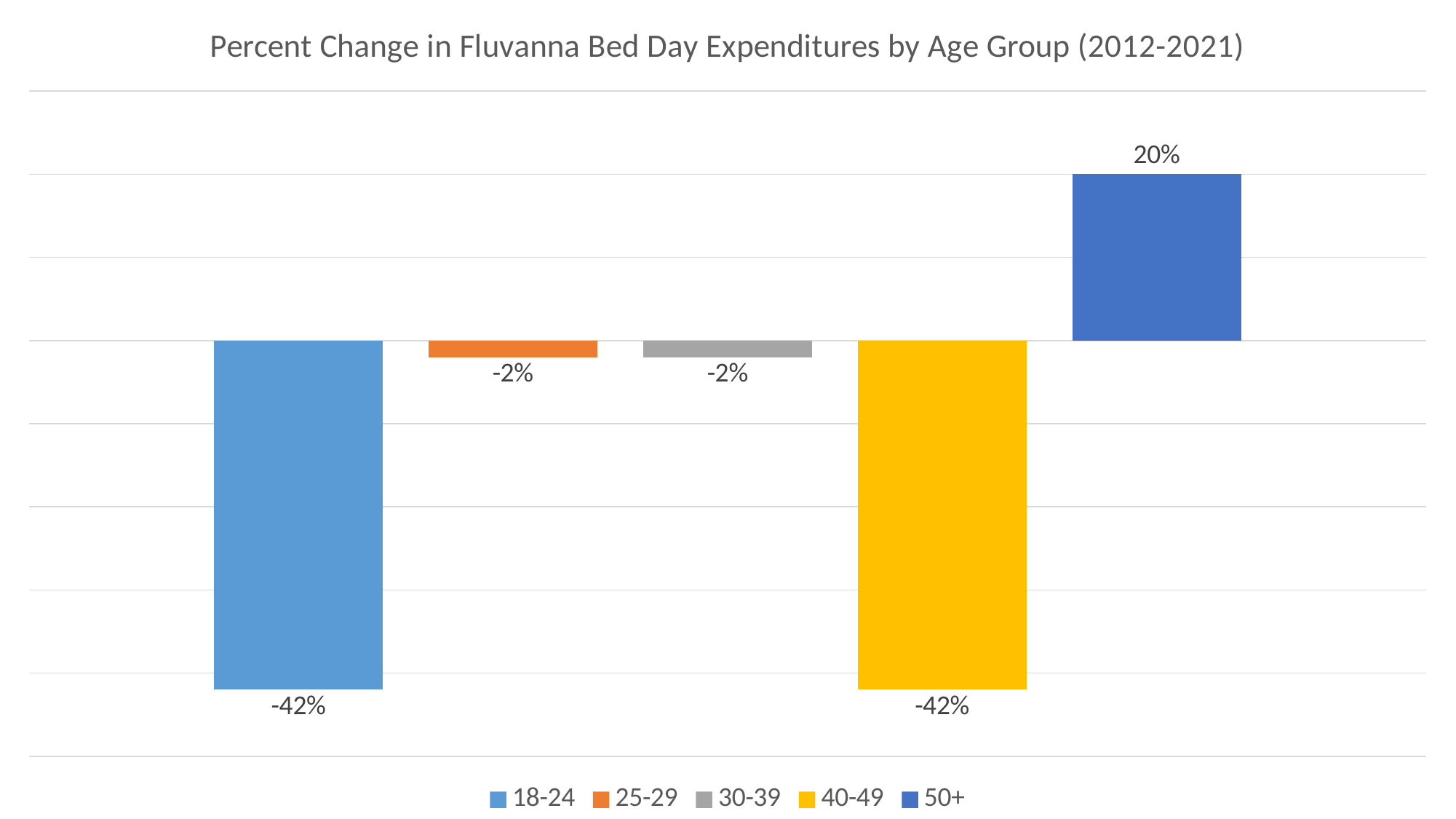
What is the percent change in Fluvanna bed day expenditures for the 40-49 age group? -42% What is the percent change in Fluvanna bed day expenditures for the 25-29 age group? -2% What is the difference between the percent change for the 50+ group and the 40-49 group? 62 percentage points How many age groups are shown in the chart? 5 How many entries does the legend list? 5 What is the percent change in Fluvanna bed day expenditures for the 18-24 age group? -42% What is the percent change in Fluvanna bed day expenditures for the 50+ age group? 20% Which is larger, the percent change for the 30-39 group or the 18-24 group? 30-39 What is the title of the chart? Percent Change in Fluvanna Bed Day Expenditures by Age Group (2012-2021) What colour is the bar for the 40-49 age group? Yellow Which age group has the highest percent change in bed day expenditures? 50+ What kind of chart is shown on the slide? Bar chart